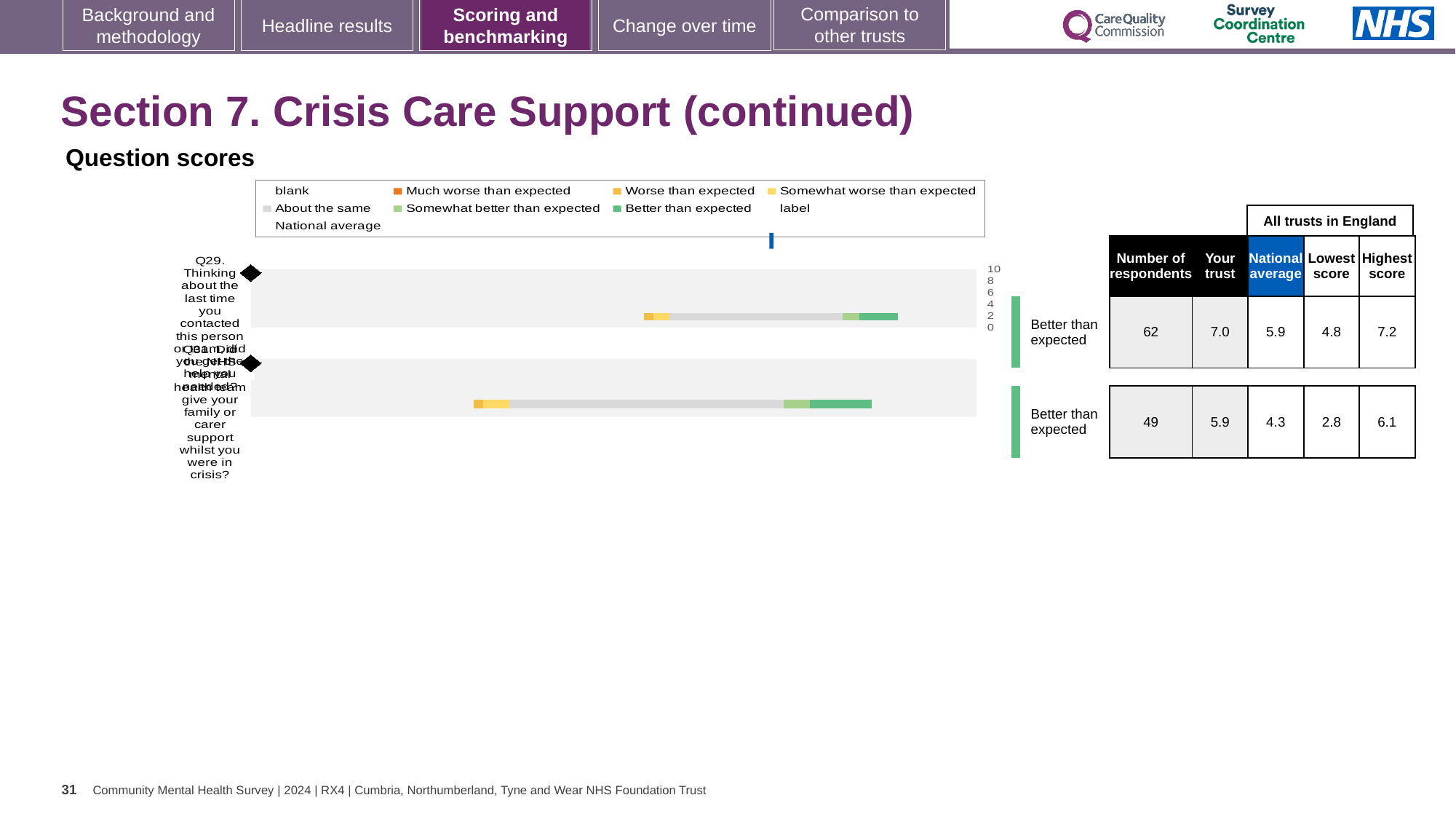
What colour does the legend use for 'Better than expected'? green How many questions (categories) are plotted in the question scores chart? 2 According to the table beside the chart, what is the national average score for Q31? 4.3 What is the highest tick value shown on the chart's score axis? 10 According to the table beside the chart, what is the highest score among all trusts in England for Q31? 6.1 What is the difference between the 'Your trust' score and the national average for Q29 in the table beside the chart? 1.1 According to the table beside the chart, what is the 'Your trust' score for Q29? 7.0 What rating label is shown next to the chart for both Q29 and Q31? Better than expected Which question has the higher 'Your trust' score in the table beside the chart, Q29 or Q31? Q29 Which two questions are plotted in the question scores chart? Q29 and Q31 According to the table beside the chart, how many respondents answered Q31? 49 What kind of chart is used to show the question scores on this slide? bar chart